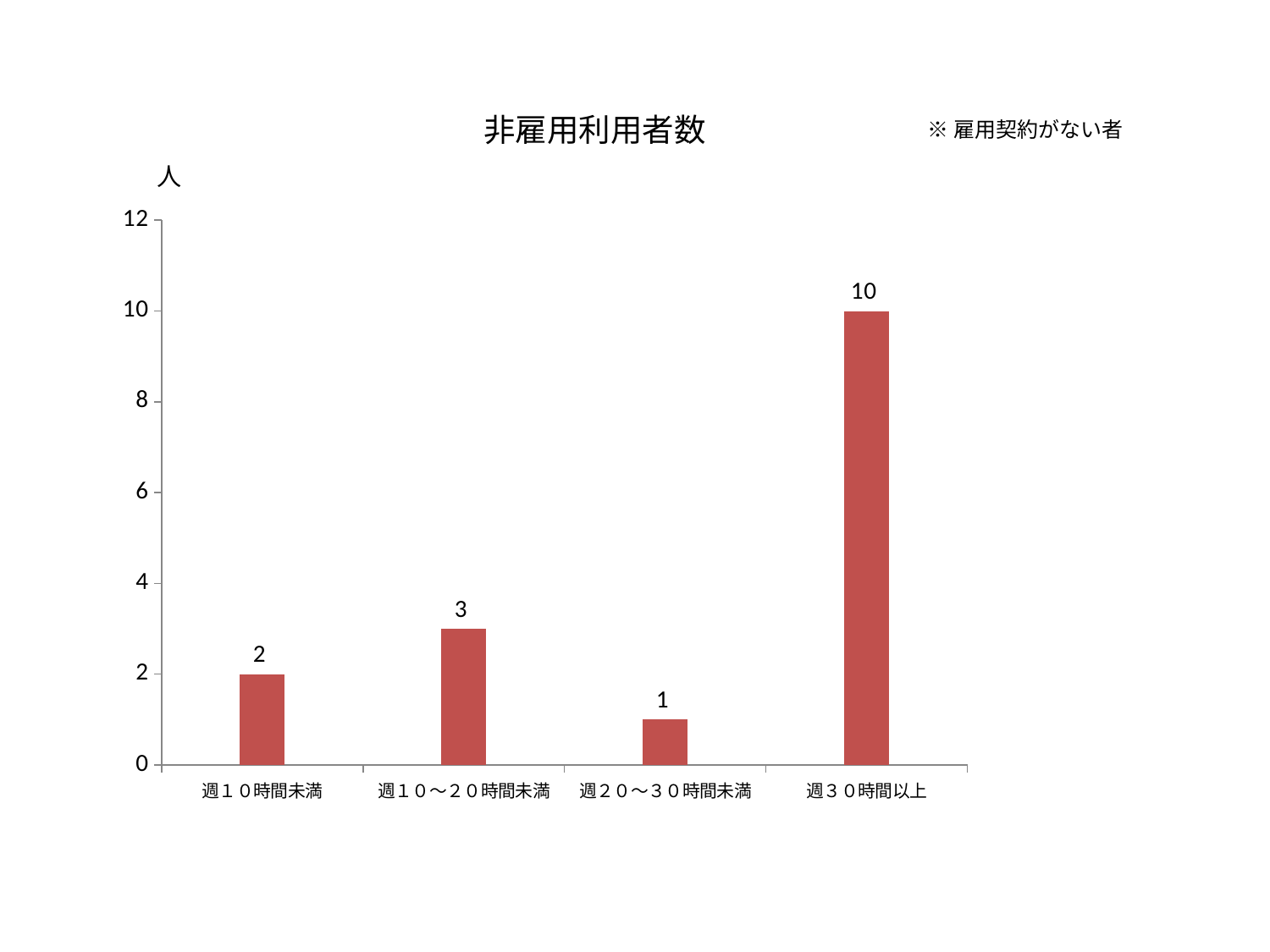
Which category has the lowest value? 週２０～３０時間未満 What unit label is shown at the top of the vertical axis? 人 How many categories are shown on the x axis? 4 What kind of chart is this? Bar chart What is the value for 週２０～３０時間未満? 1 Which category has the highest value? 週３０時間以上 What is the value for 週３０時間以上? 10 What is the difference between the values for 週３０時間以上 and 週１０～２０時間未満? 7 Which is larger, the value for 週１０時間未満 or the value for 週１０～２０時間未満? 週１０～２０時間未満 What is the value for 週１０～２０時間未満? 3 What is the title of the chart? 非雇用利用者数 What is the value for 週１０時間未満? 2